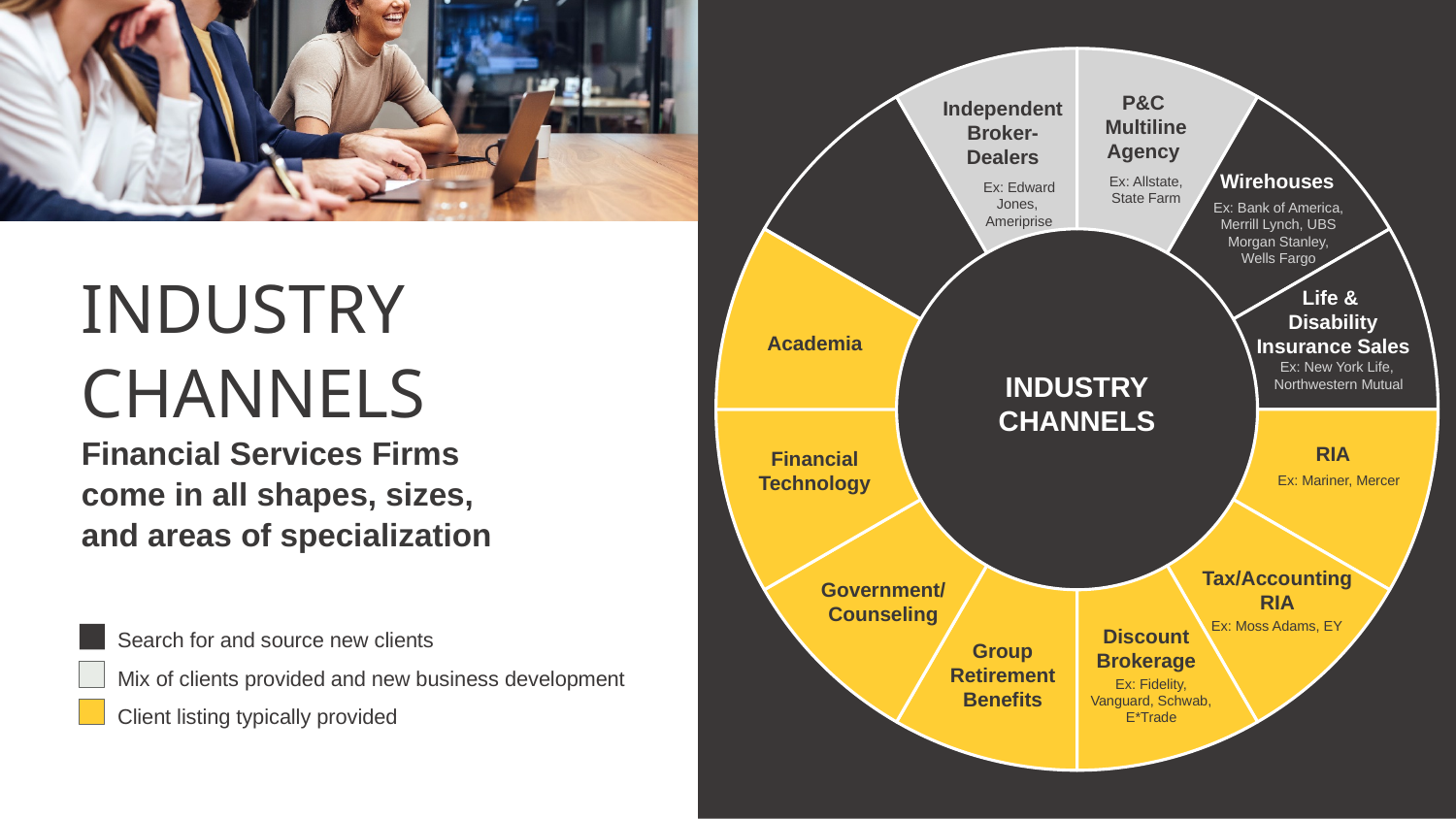
How many industry channel segments are shown in the ring? 12 Which example firms are listed for the Discount Brokerage segment? Fidelity, Vanguard, Schwab, E*Trade Which example firms are listed for the RIA segment? Mariner, Mercer How many segments of the ring are coloured light gray? 2 According to the legend, what does the yellow colour represent? Client listing typically provided What text appears in the centre of the ring? INDUSTRY CHANNELS How many segments of the ring are coloured dark gray? 3 How many categories does the legend on the left list? 3 What kind of chart is used to show the industry channels? Doughnut chart Which example firms are listed for the P&C Multiline Agency segment? Allstate, State Farm